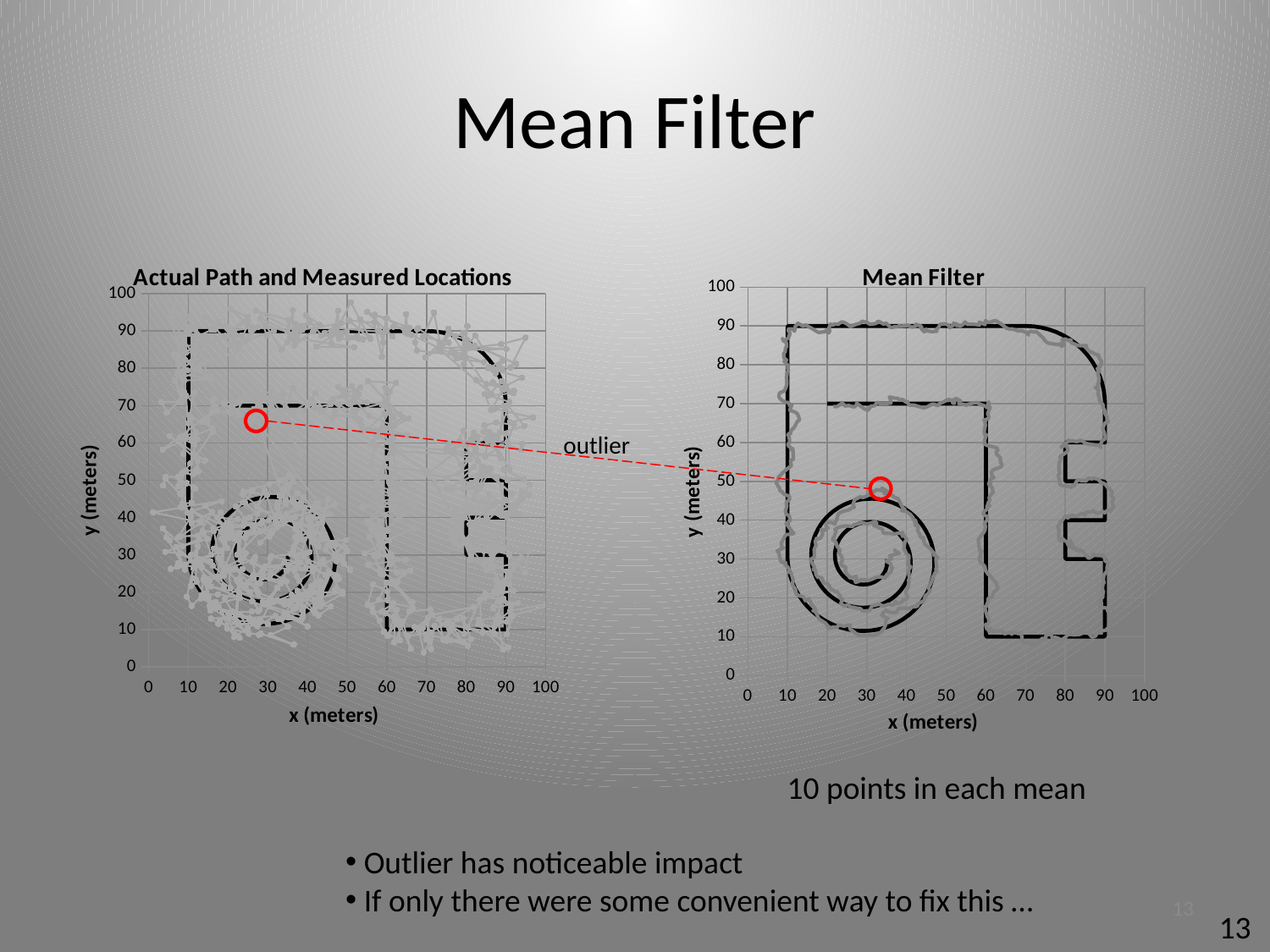
In the "Actual Path and Measured Locations" chart, is the x value of the red-circled outlier greater or less than 40? less In the "Actual Path and Measured Locations" chart, is the y value of the bottom horizontal segment of the dashed actual path greater or less than 20? less In the "Mean Filter" chart, is the y value of the red-circled point greater or less than 40? greater What kind of chart is the "Mean Filter" chart? scatter chart What kind of chart is the "Actual Path and Measured Locations" chart? scatter chart What is the x-axis label of the "Mean Filter" chart? x (meters) How many charts are shown on the slide? 2 What is the title of the chart on the left side of the slide? Actual Path and Measured Locations